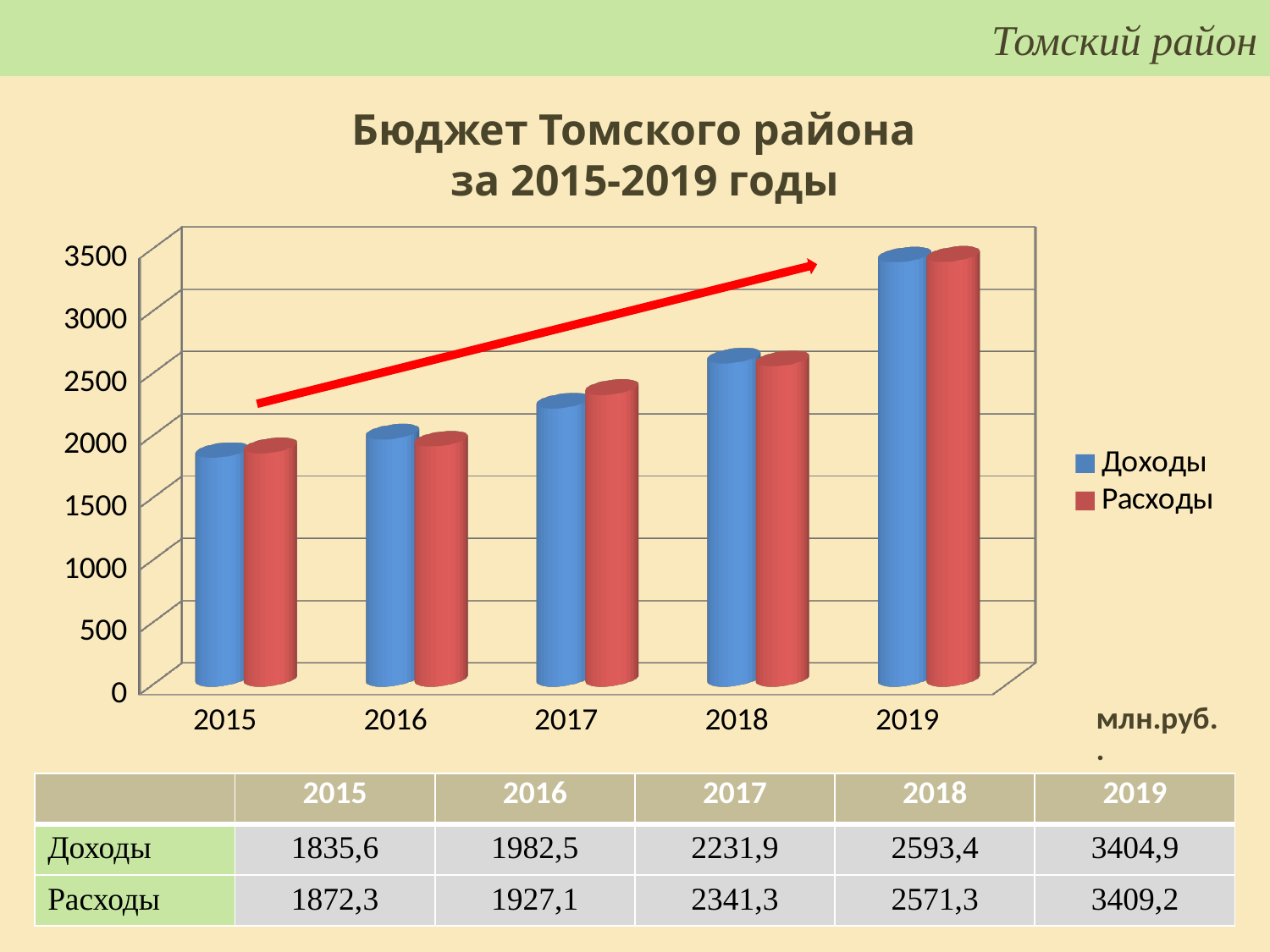
What is the value of Расходы for 2017? 2341,3 Is the value of Доходы for 2018 greater or less than 2500? greater What kind of chart is shown on the slide? Bar chart In which year is Расходы the lowest? 2015 In which year is Доходы the highest? 2019 What is the title of the chart? Бюджет Томского района за 2015-2019 годы What is the difference between Доходы in 2019 and Доходы in 2018? 811,5 Do the Доходы values rise or fall from 2015 to 2019? Rise In 2017, which is larger: Доходы or Расходы? Расходы How many series does the chart legend list? 2 How many years are shown along the x axis of the chart? 5 What is the value of Доходы for 2019? 3404,9